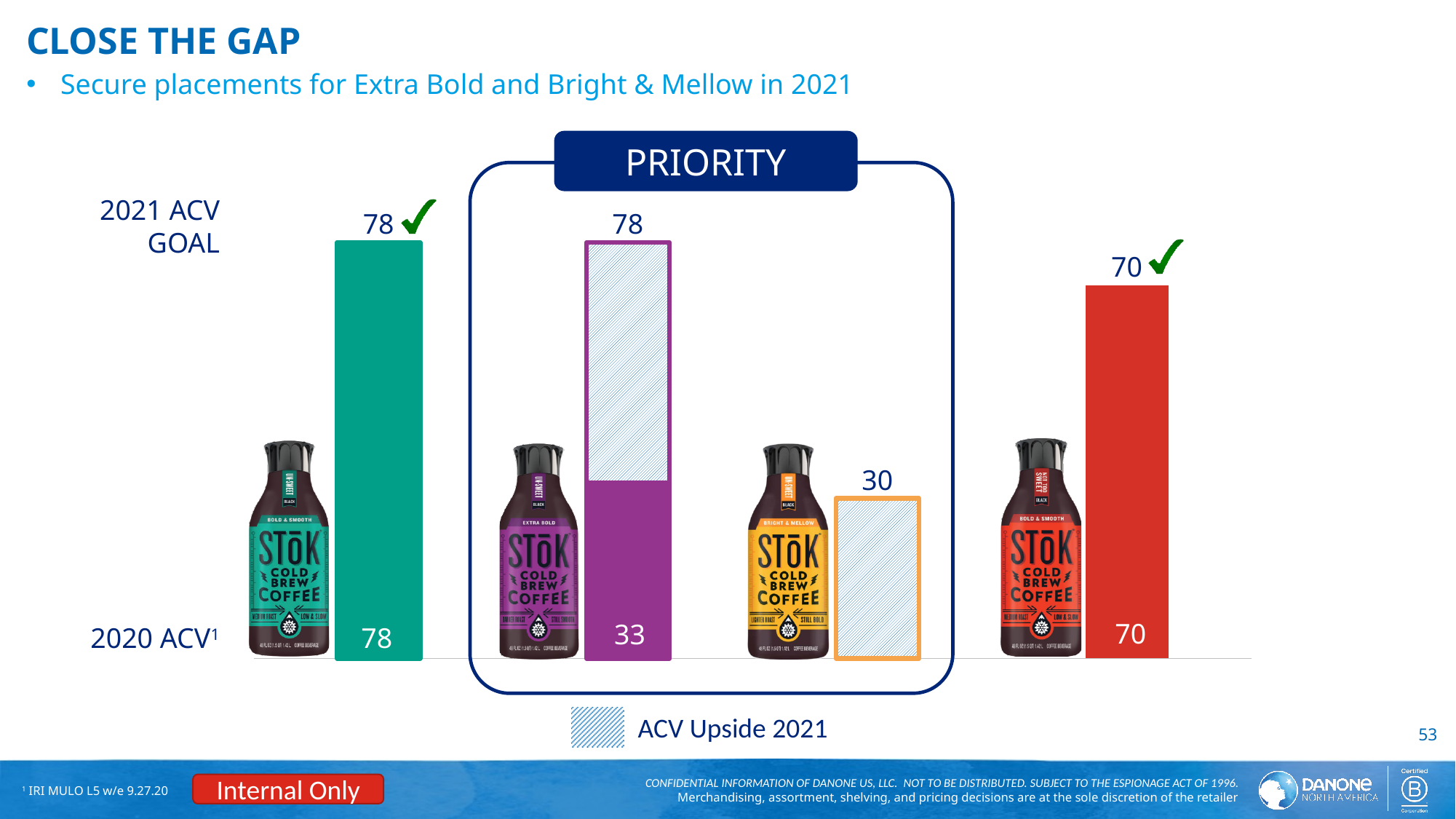
Which product has the lowest 2021 ACV goal? Bright & Mellow What is the 2021 ACV goal for Bright & Mellow? 30 Which is larger, the 2020 ACV for Extra Bold or the 2020 ACV for Not Too Sweet? Not Too Sweet What does the hatched pattern in the bars represent, according to the legend? ACV Upside 2021 What is the difference between the 2021 ACV goal and the 2020 ACV for Extra Bold? 45 How many products (bars) are shown in the chart? 4 What is the 2020 ACV for Extra Bold? 33 What is the 2021 ACV goal for Extra Bold? 78 What kind of chart is shown on the slide? Bar chart Which products are inside the PRIORITY box? Extra Bold and Bright & Mellow What is the 2020 ACV for the Un-Sweet product (green bar)? 78 What is the 2020 ACV for the Not Too Sweet product (red bar)? 70